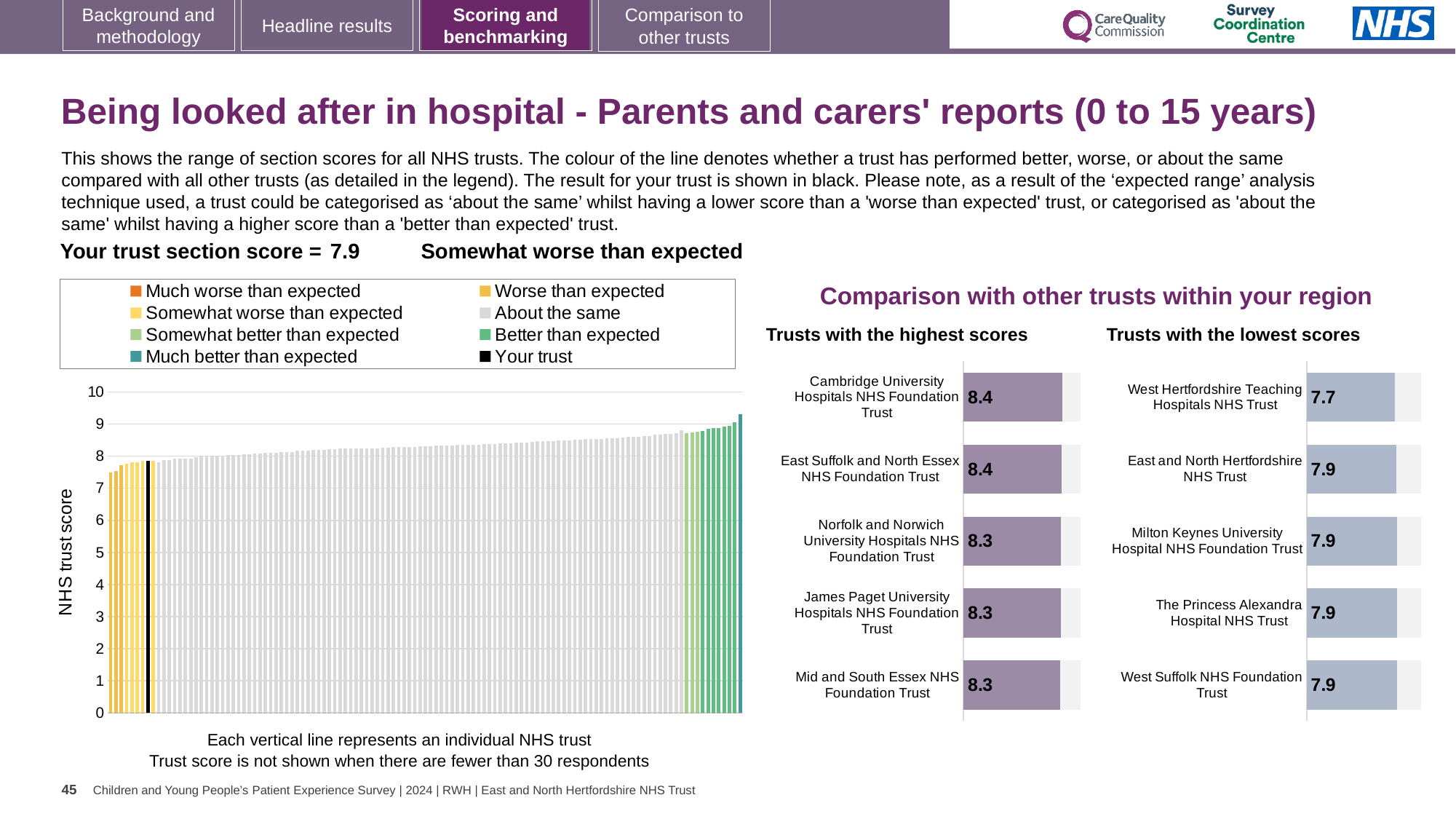
How many entries does the legend of the large chart on the left list? 8 What kind of chart is the large chart on the left showing NHS trust scores? Bar chart How many trusts are listed in the 'Trusts with the lowest scores' chart? 5 In the 'Trusts with the lowest scores' chart, which trust has the lowest score? West Hertfordshire Teaching Hospitals NHS Trust In the large chart on the left, is the value of the black bar (your trust) greater or less than 7? greater In the 'Trusts with the lowest scores' chart, what is the score for West Hertfordshire Teaching Hospitals NHS Trust? 7.7 In the 'Trusts with the highest scores' chart, which has the larger score: Cambridge University Hospitals NHS Foundation Trust or Mid and South Essex NHS Foundation Trust? Cambridge University Hospitals NHS Foundation Trust In the 'Trusts with the lowest scores' chart, what is the difference between the score for West Suffolk NHS Foundation Trust and the score for West Hertfordshire Teaching Hospitals NHS Trust? 0.2 In the 'Trusts with the highest scores' chart, what is the score for Norfolk and Norwich University Hospitals NHS Foundation Trust? 8.3 In the large chart on the left, do the NHS trust scores rise or fall from left to right? Rise In the 'Trusts with the highest scores' chart, what is the score for Cambridge University Hospitals NHS Foundation Trust? 8.4 In the 'Trusts with the highest scores' chart, what is the difference between the score for East Suffolk and North Essex NHS Foundation Trust and the score for James Paget University Hospitals NHS Foundation Trust? 0.1